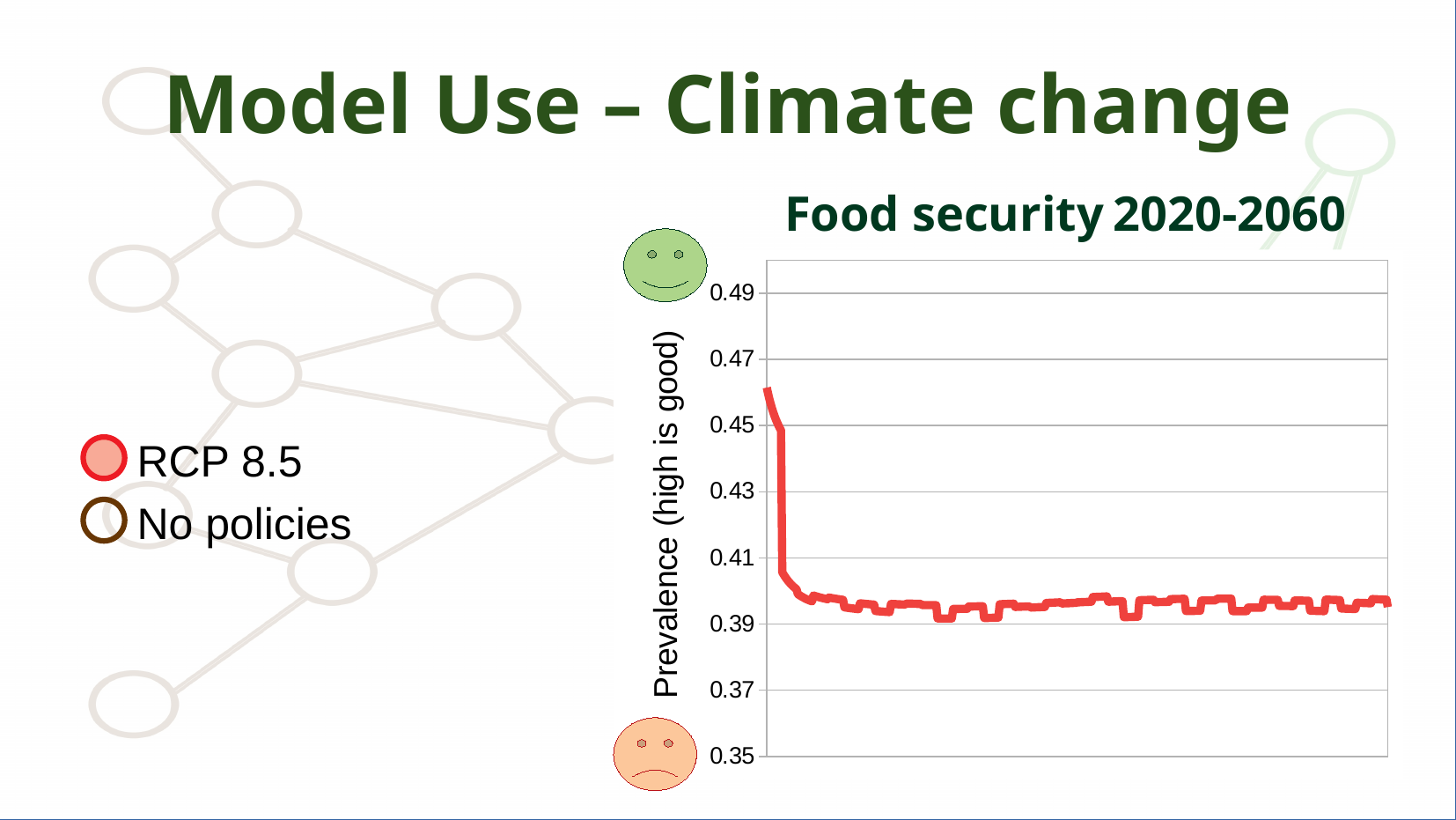
Is the value at the end of the plotted line greater or less than 0.41? less How many entries does the legend on the slide list? 2 What kind of chart is shown on the slide? line chart What is the highest value shown on the vertical axis? 0.49 Is the value at the start of the plotted line greater or less than 0.43? greater Does the plotted line rise or fall overall from the start to the end of the period? fall Is the lowest point of the plotted line greater or less than 0.37? greater Which legend entry corresponds to the red line plotted on the chart? RCP 8.5 What is the label on the vertical axis of the chart? Prevalence (high is good)